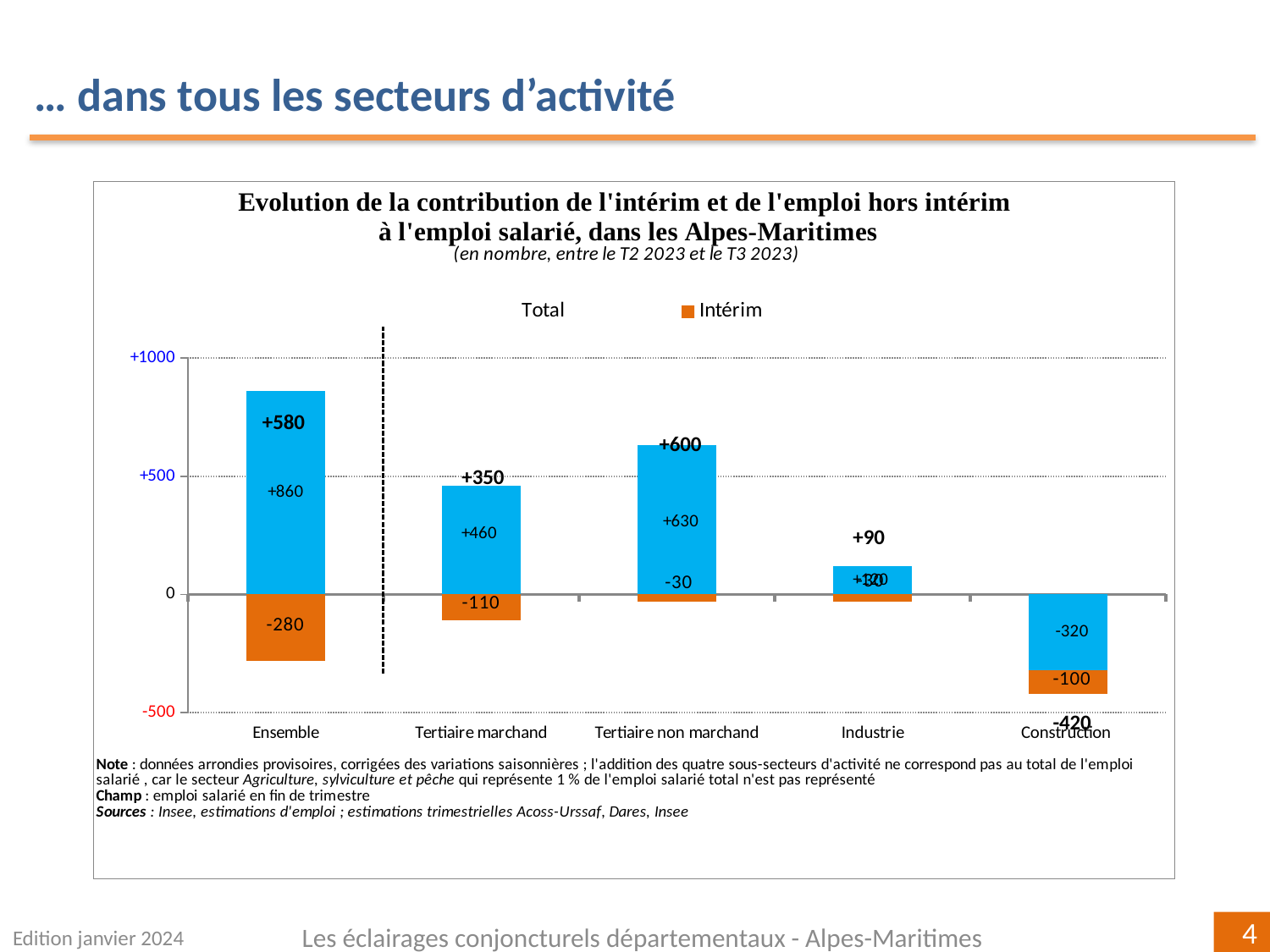
What is the value of the blue (hors intérim) segment for Tertiaire marchand? +460 How many entries does the chart legend list? 2 What is the total value shown for Construction? -420 How many sectors (categories) are shown on the x axis of the chart? 5 Which sector has the lowest total value? Construction What is the Intérim value shown for Construction? -100 What is the difference between the total for Tertiaire non marchand and the total for Tertiaire marchand? 250 Which sector has the highest total value? Tertiaire non marchand Which has the larger Intérim decline, Ensemble or Tertiaire marchand? Ensemble What kind of chart is shown on the slide? bar chart What is the Intérim value shown for Ensemble? -280 What is the total value shown for Ensemble? +580